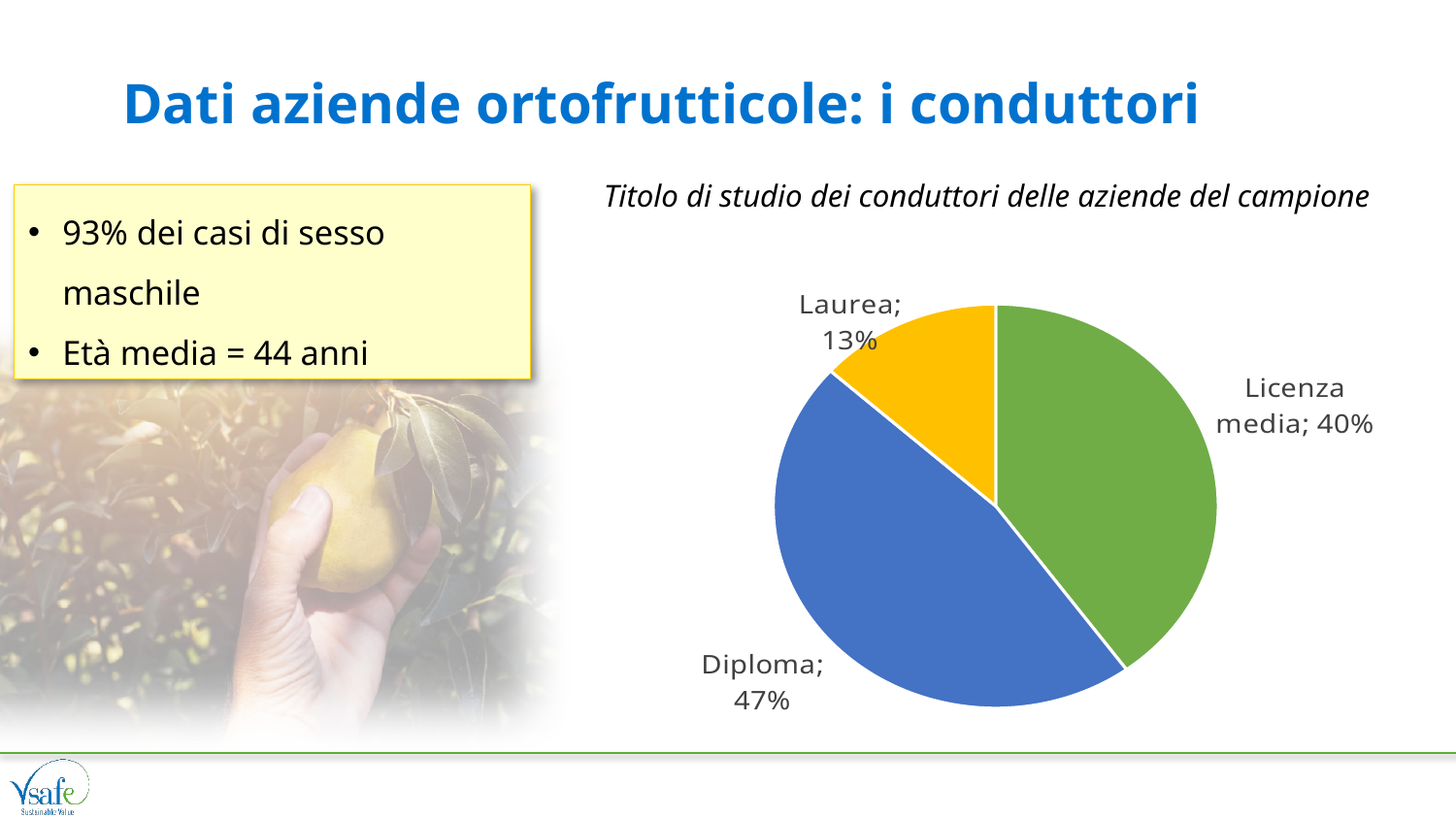
What share of the pie does Laurea represent? 13% What is the difference in percentage points between Diploma and Licenza media? 7 Which category has the largest slice of the pie? Diploma What share of the pie does Diploma represent? 47% Which is larger, the slice for Diploma or the slice for Laurea? Diploma What share of the pie does Licenza media represent? 40% What colour is the Laurea slice? yellow How many slices does the pie chart have? 3 What is the title of the pie chart? Titolo di studio dei conduttori delle aziende del campione What is the difference in percentage points between Licenza media and Laurea? 27 What kind of chart is shown on the slide? pie chart Which category has the smallest slice of the pie? Laurea